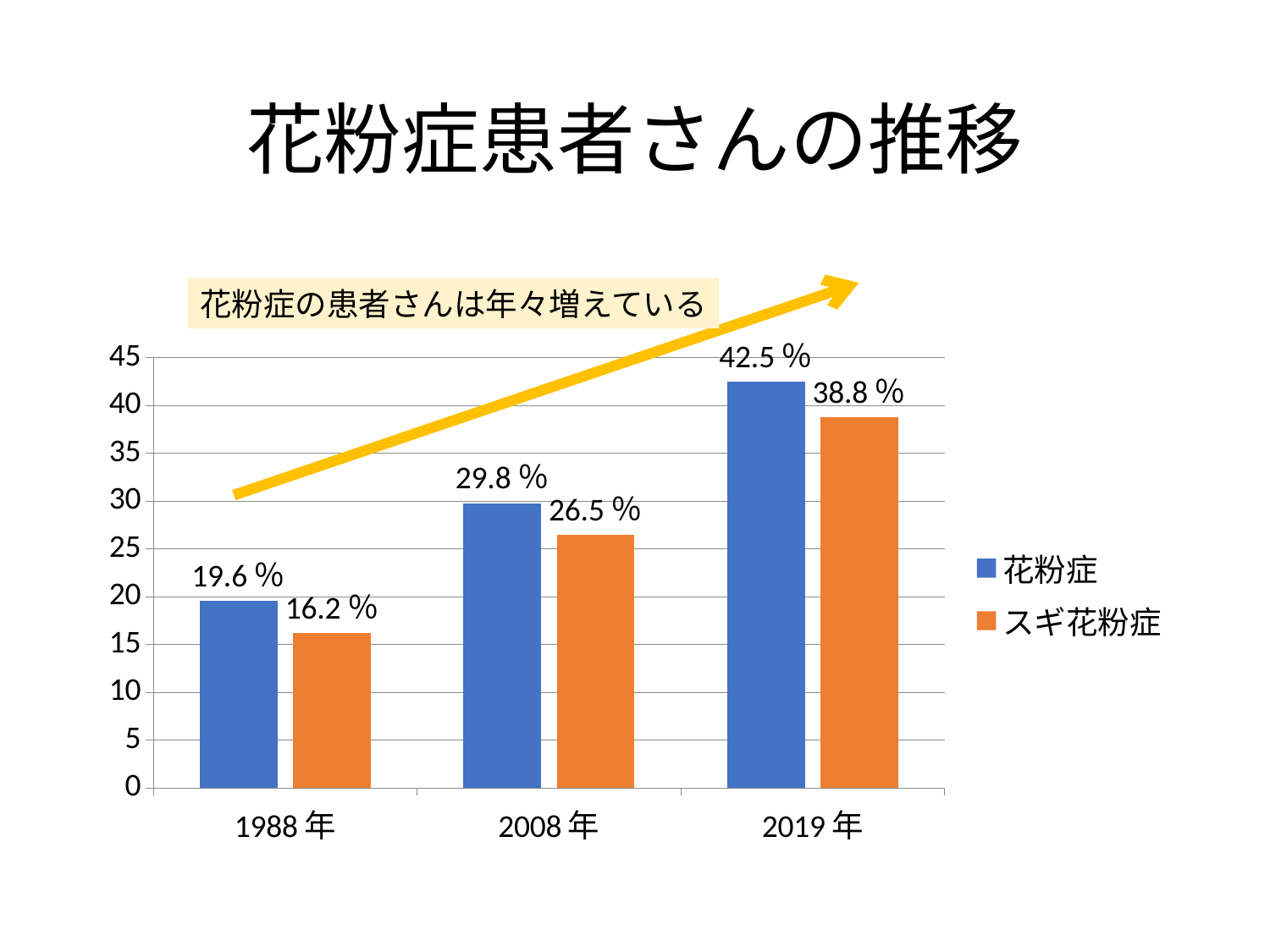
What is the value for スギ花粉症 in 2008年? 26.5% What is the value for スギ花粉症 in 2019年? 38.8% Which year has the lowest value for スギ花粉症? 1988年 How many years are shown on the x axis? 3 What is the value for 花粉症 in 1988年? 19.6% Do the 花粉症 values rise or fall from 1988年 to 2019年? Rise What is the difference between the 花粉症 and スギ花粉症 values in 2019年? 3.7% Which year has the highest value for 花粉症? 2019年 What is the difference between the 花粉症 values for 2008年 and 1988年? 10.2% What kind of chart is shown on the slide? Bar chart Which is larger in 2008年, 花粉症 or スギ花粉症? 花粉症 How many series does the legend list? 2